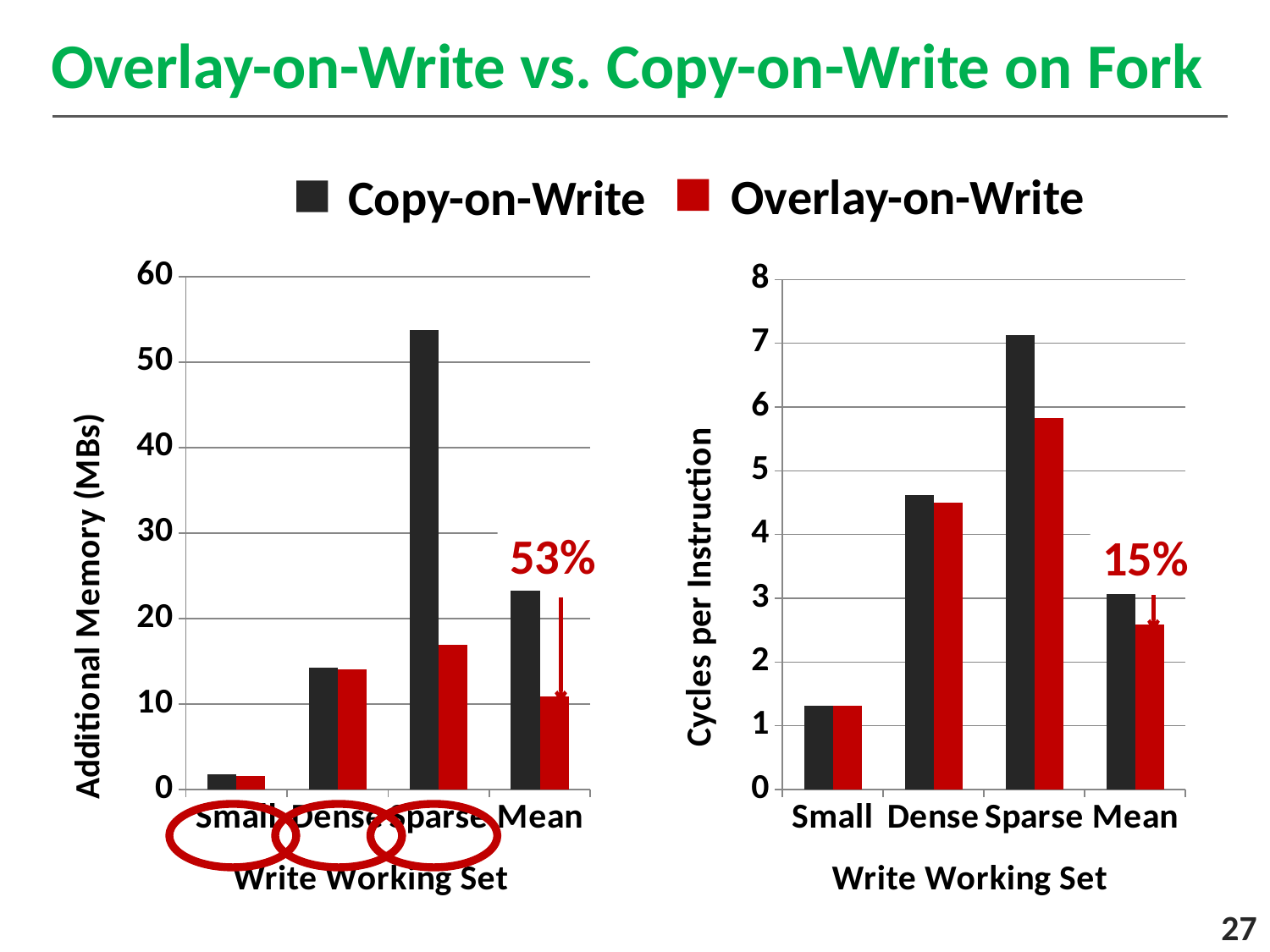
How many series does the legend list? 2 In the left chart (Additional Memory), which is larger for Sparse: Copy-on-Write or Overlay-on-Write? Copy-on-Write What kind of chart is the left chart (Additional Memory)? bar chart In the left chart (Additional Memory), is the Copy-on-Write value for Sparse greater or less than 50? greater In the right chart (Cycles per Instruction), is the Overlay-on-Write value for Mean greater or less than 3? less What percentage reduction is annotated above the Mean bars in the right chart (Cycles per Instruction)? 15% How many categories are shown on the x axis of the right chart (Cycles per Instruction)? 4 In the left chart (Additional Memory), is the Overlay-on-Write value for Sparse greater or less than 20? less In the left chart (Additional Memory), which category has the highest Copy-on-Write value? Sparse In the right chart (Cycles per Instruction), which category has the lowest Overlay-on-Write value? Small What is the x-axis title of the left chart (Additional Memory)? Write Working Set